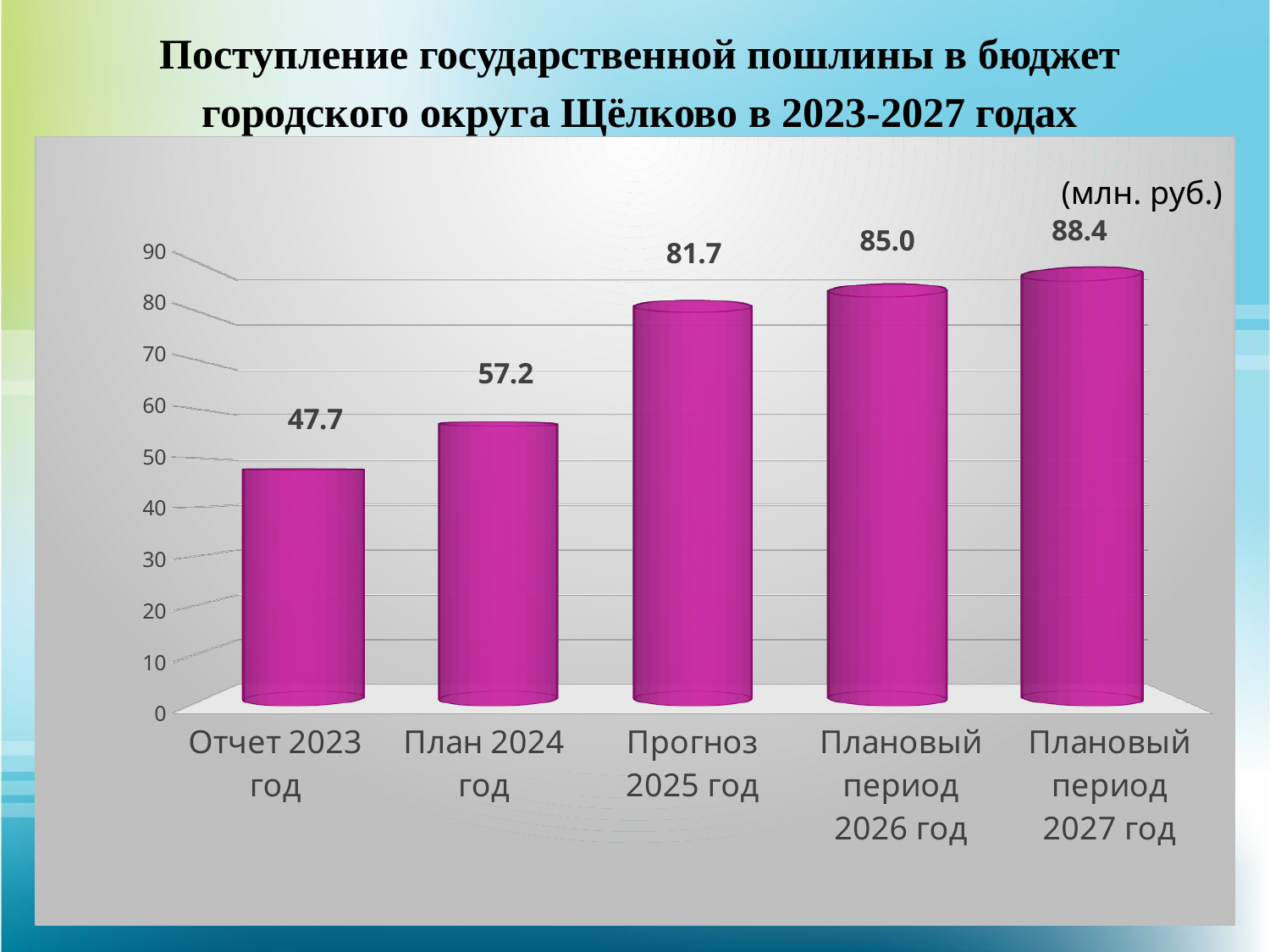
What is the value for Прогноз 2025 год? 81.7 What kind of chart is shown on the slide? bar chart Which is larger, the value for Прогноз 2025 год or the value for План 2024 год? Прогноз 2025 год What is the difference between the values for План 2024 год and Отчет 2023 год? 9.5 What is the value for План 2024 год? 57.2 Do the values rise or fall from Отчет 2023 год to Плановый период 2027 год? rise How many categories are shown on the chart? 5 Which category has the lowest value? Отчет 2023 год What is the value for Плановый период 2027 год? 88.4 What is the difference between the values for Плановый период 2026 год and Плановый период 2027 год? 3.4 Which category has the highest value? Плановый период 2027 год What is the value for Отчет 2023 год? 47.7